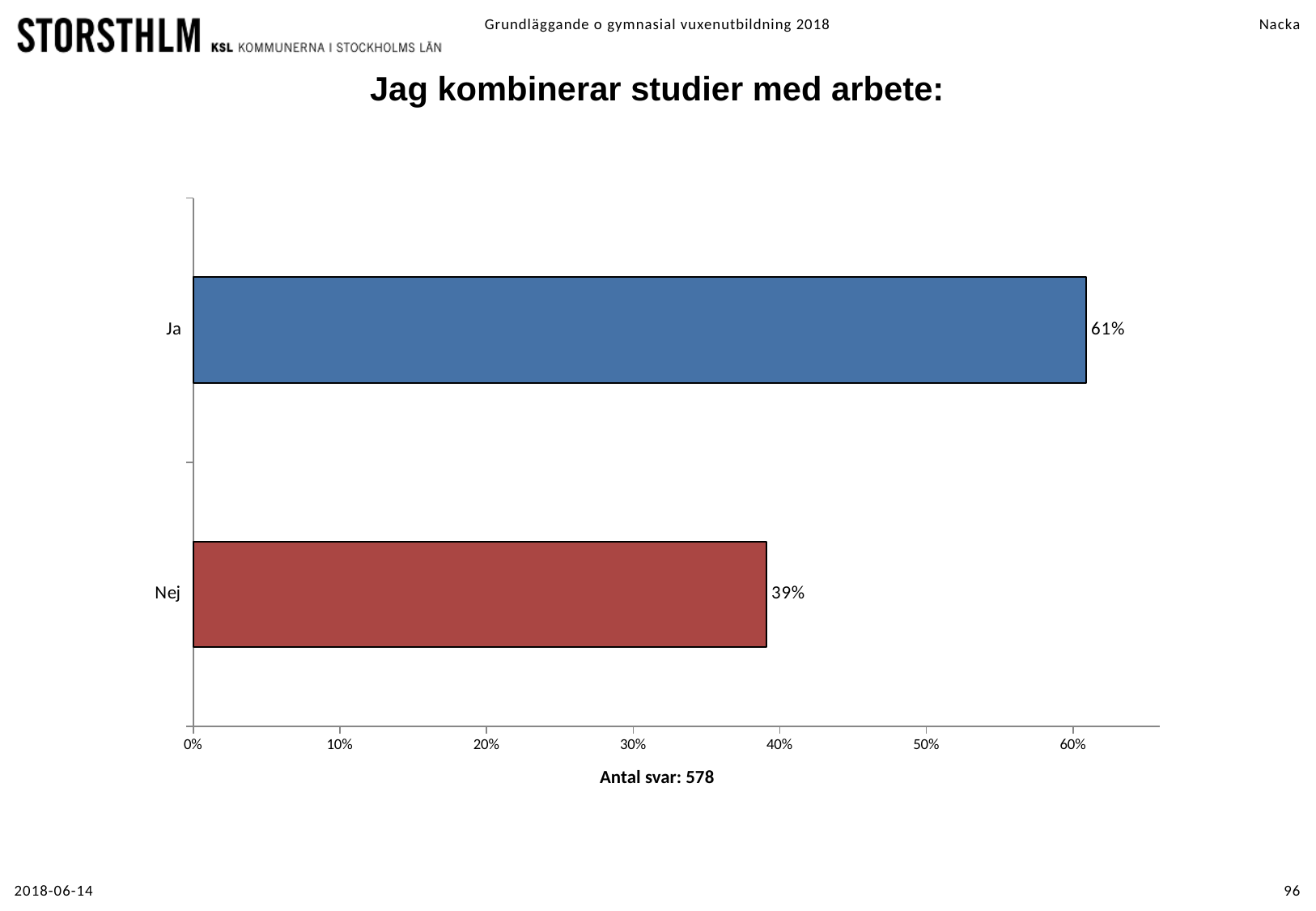
Which category has the highest value? Ja Which category has the lowest value? Nej What is the value for Nej? 39% What kind of chart is shown on the slide? bar chart How many categories are shown in the chart? 2 What is the difference between the values for Ja and Nej? 22% What is the value for Ja? 61% What is the number of responses (Antal svar) shown below the chart? 578 Which is larger, the value for Ja or the value for Nej? Ja What is the title of the chart? Jag kombinerar studier med arbete: Is the value for Nej greater or less than 40%? less Is the value for Ja greater or less than 50%? greater